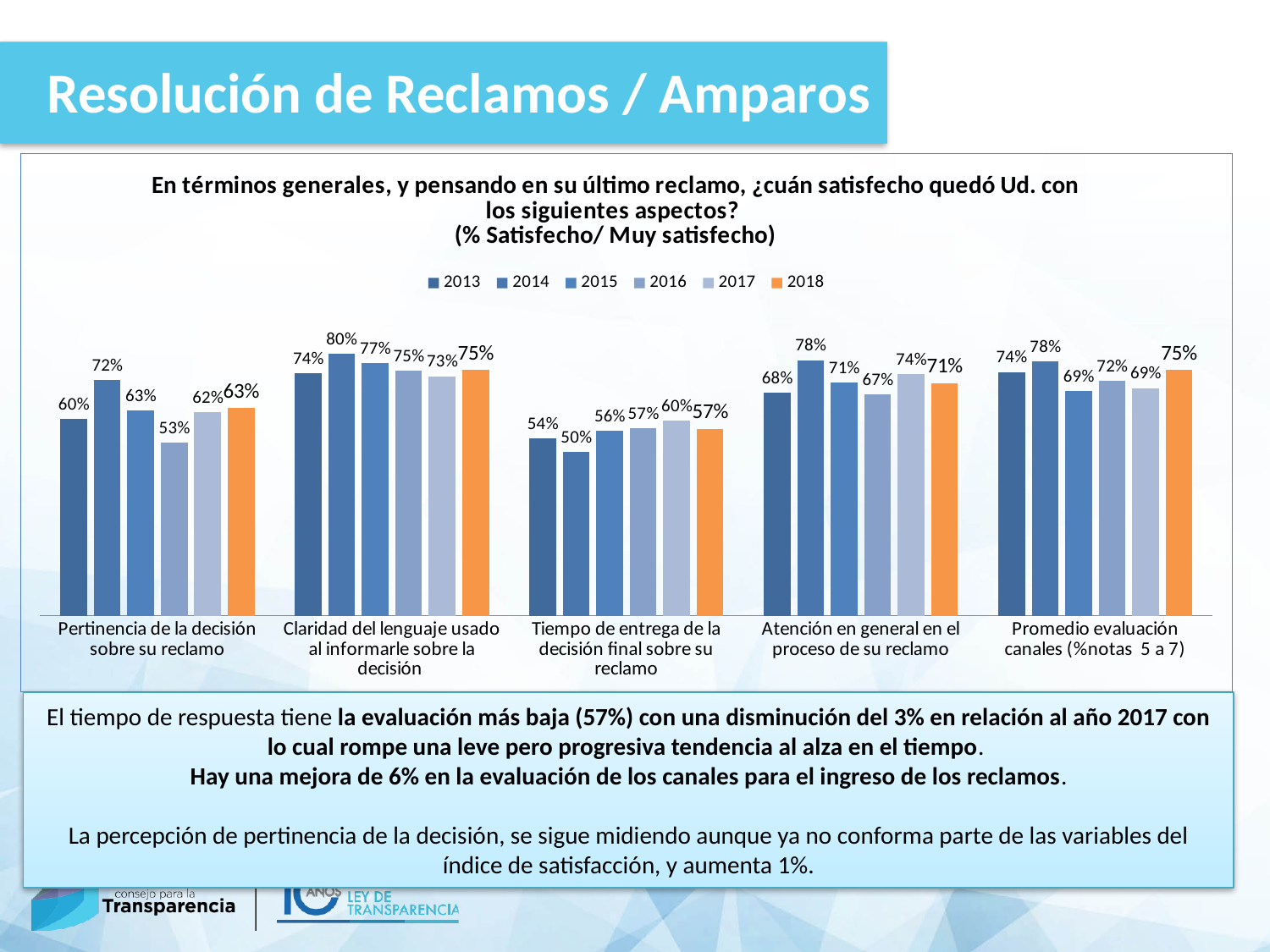
What type of chart is shown on the slide? Bar chart Which is larger for 'Atención en general en el proceso de su reclamo': the 2014 value or the 2018 value? 2014 How many series does the legend list? 6 What is the 2018 value for 'Tiempo de entrega de la decisión final sobre su reclamo'? 57% What is the 2014 value for 'Claridad del lenguaje usado al informarle sobre la decisión'? 80% Which year's series is shown in orange in the legend? 2018 Which category has the highest 2018 value? Claridad del lenguaje usado al informarle sobre la decisión and Promedio evaluación canales (%notas 5 a 7) (tied at 75%) How many categories are shown on the x axis? 5 Which category has the lowest 2018 value? Tiempo de entrega de la decisión final sobre su reclamo What is the 2016 value for 'Pertinencia de la decisión sobre su reclamo'? 53% What is the difference between the 2017 and 2018 values for 'Promedio evaluación canales (%notas 5 a 7)'? 6% For 'Tiempo de entrega de la decisión final sobre su reclamo', do the values rise or fall from 2014 to 2017? Rise